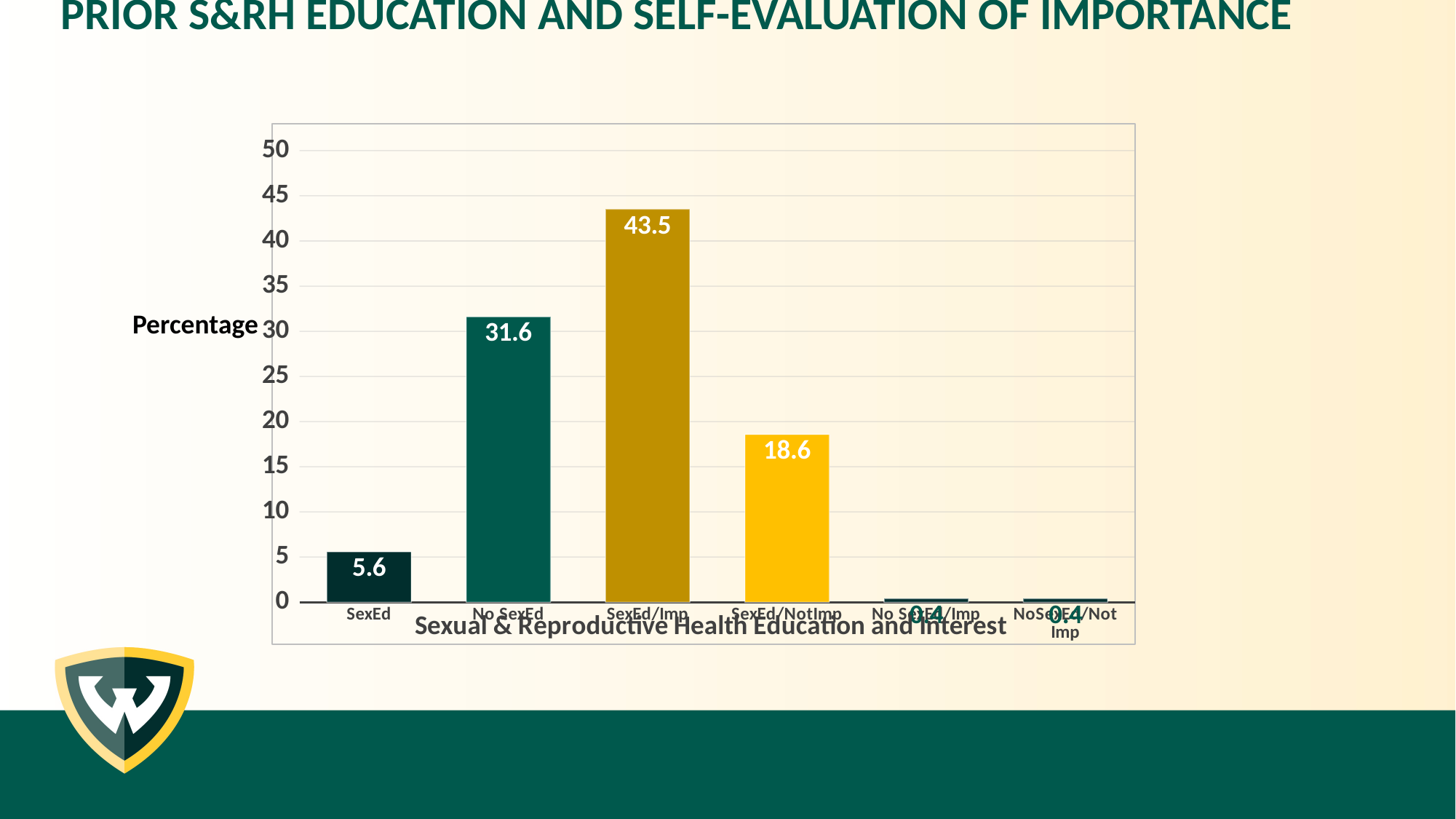
What is the value for SexEd? 5.6 What kind of chart is shown on the slide? bar chart What is the difference between the values for SexEd/Imp and No SexEd? 11.9 What is the value for SexEd/NotImp? 18.6 What is the difference between the values for SexEd/NotImp and SexEd? 13 Which category has the highest value? SexEd/Imp Which is larger, the value for No SexEd or the value for SexEd/NotImp? No SexEd What is the label of the vertical axis? Percentage What is the value for No SexEd? 31.6 What is the value for SexEd/Imp? 43.5 Is the value for SexEd/Imp greater or less than 40? greater How many categories are shown on the x axis? 6